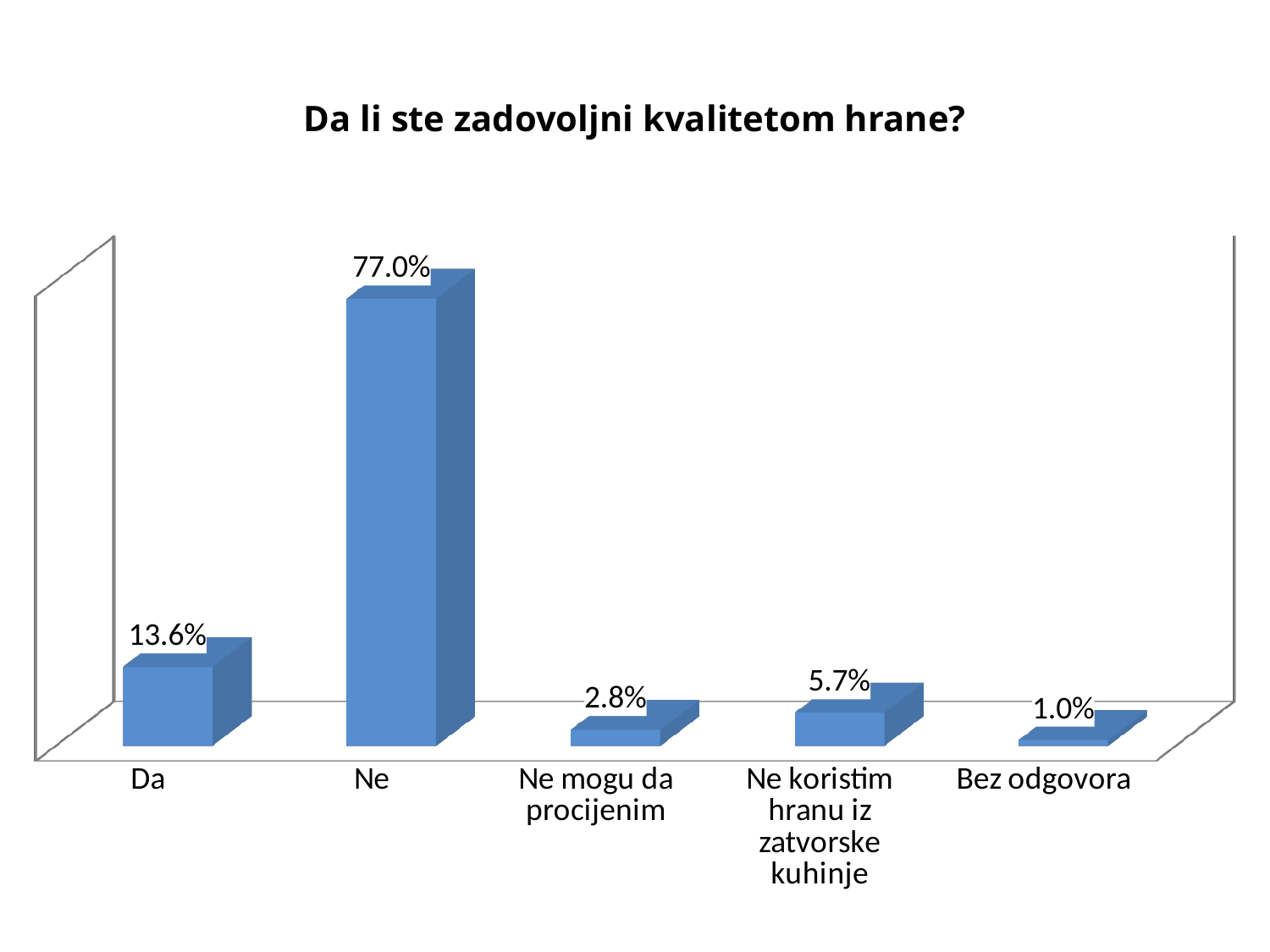
What is the difference between the values for "Ne koristim hranu iz zatvorske kuhinje" and "Ne mogu da procijenim"? 2.9% How many categories are shown on the chart? 5 What is the value for "Bez odgovora"? 1.0% Which category has the highest value? Ne What is the value for "Ne"? 77.0% Which is larger, the value for "Da" or the value for "Ne mogu da procijenim"? Da What is the title of the chart? Da li ste zadovoljni kvalitetom hrane? What is the difference between the values for "Ne" and "Da"? 63.4% What is the value for "Ne koristim hranu iz zatvorske kuhinje"? 5.7% What kind of chart is shown on the slide? Bar chart What is the value for "Da"? 13.6% Which category has the lowest value? Bez odgovora